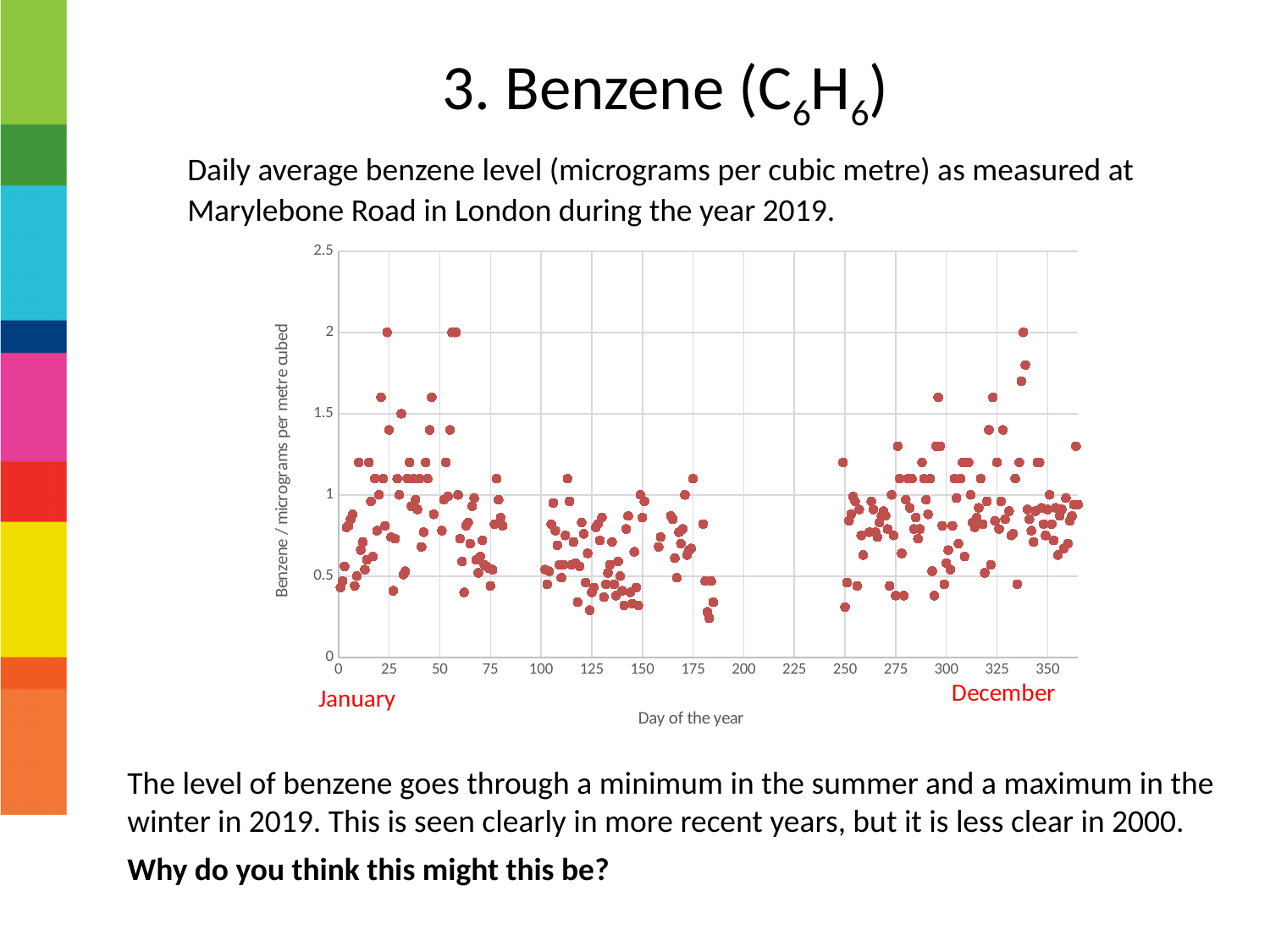
What is the highest value shown on the vertical axis of the chart? 2.5 Is the highest benzene value plotted on the chart greater or less than 2.5? less What is the label on the horizontal axis of the chart? Day of the year Do the benzene values generally rise or fall from day 0 to day 150? fall Which month is labelled at the right-hand end of the horizontal axis? December What kind of chart is shown on the slide? Scatter chart Are there any data points plotted between day 200 and day 225? No What is the label on the vertical axis of the chart? Benzene / micrograms per metre cubed Are the benzene values plotted around day 175 greater or less than 1.5? less What is the highest tick value shown on the horizontal axis of the chart? 350 Are the benzene values between day 100 and day 200 generally higher or lower than those between day 0 and day 100? lower Are the benzene values plotted around day 125 greater or less than 1.5? less